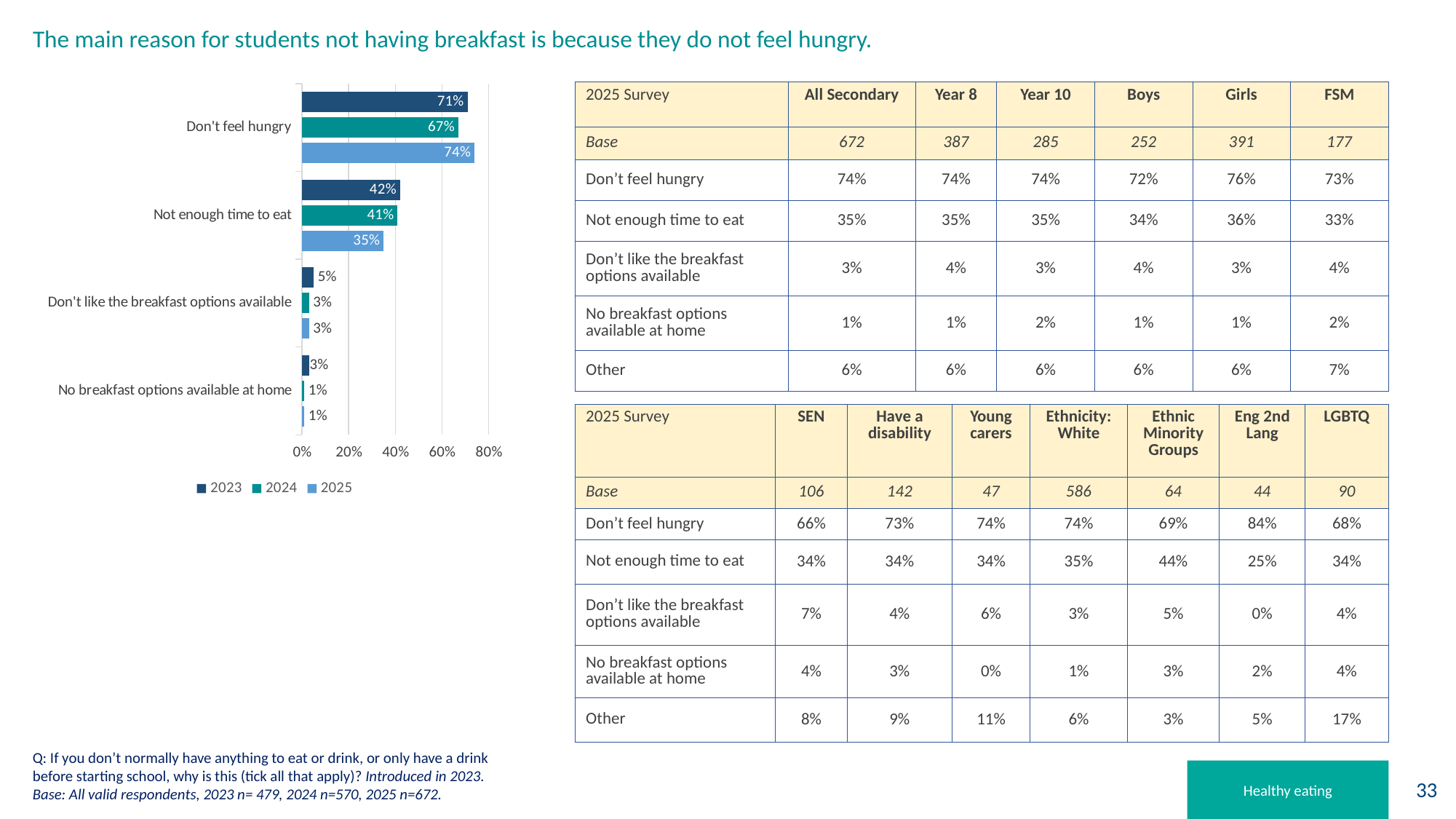
How many series does the legend list? 3 What is the difference between the 2025 and 2024 values for 'Don't feel hungry'? 7% Which category has the lowest value in the 2024 series? No breakfast options available at home What kind of chart is shown on the slide? Bar chart What is the 2023 value for 'Not enough time to eat'? 42% Which category has the highest value in the 2025 series? Don't feel hungry Which years are listed in the chart legend? 2023, 2024, 2025 What is the 2025 value for 'Don't feel hungry'? 74% Is the 2024 value for 'Don't feel hungry' greater or less than 60%? greater Which is larger for 'Not enough time to eat': the 2023 value or the 2025 value? 2023 How many categories are shown on the chart? 4 What is the 2024 value for 'Don't like the breakfast options available'? 3%